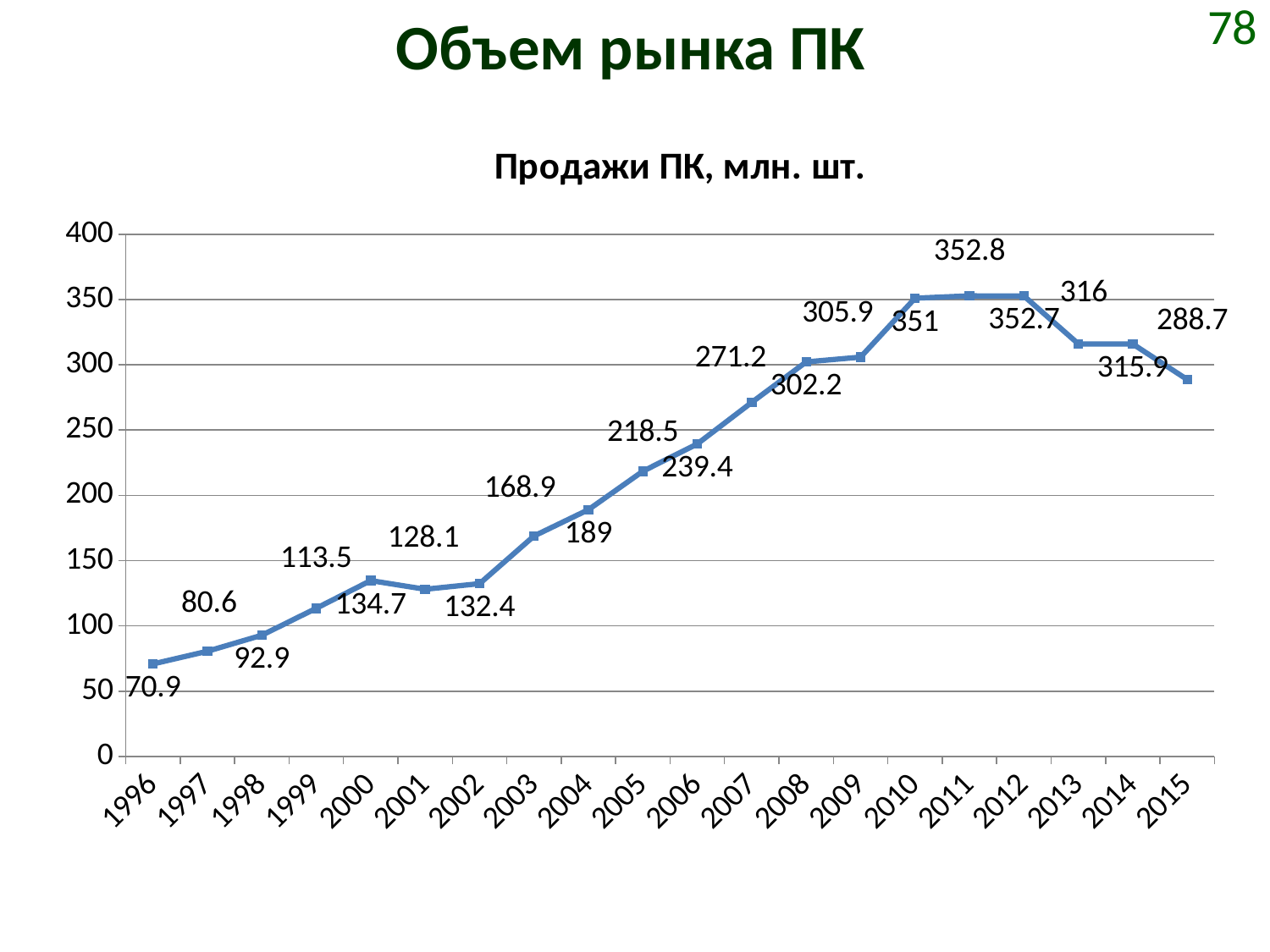
How many years are plotted on the x axis? 20 Which is larger, the value for 2000 or the value for 2001? 2000 What is the value for 2015? 288.7 Which year has the lowest value? 1996 Do the values rise or fall from 2012 to 2015? fall What is the value for 2011? 352.8 What is the value for 1996? 70.9 What is the chart's title? Продажи ПК, млн. шт. What type of chart is shown on the slide? line chart What is the difference between the values for 2008 and 2007? 31 Is the value for 2010 greater or less than 300? greater What is the value for 2004? 189